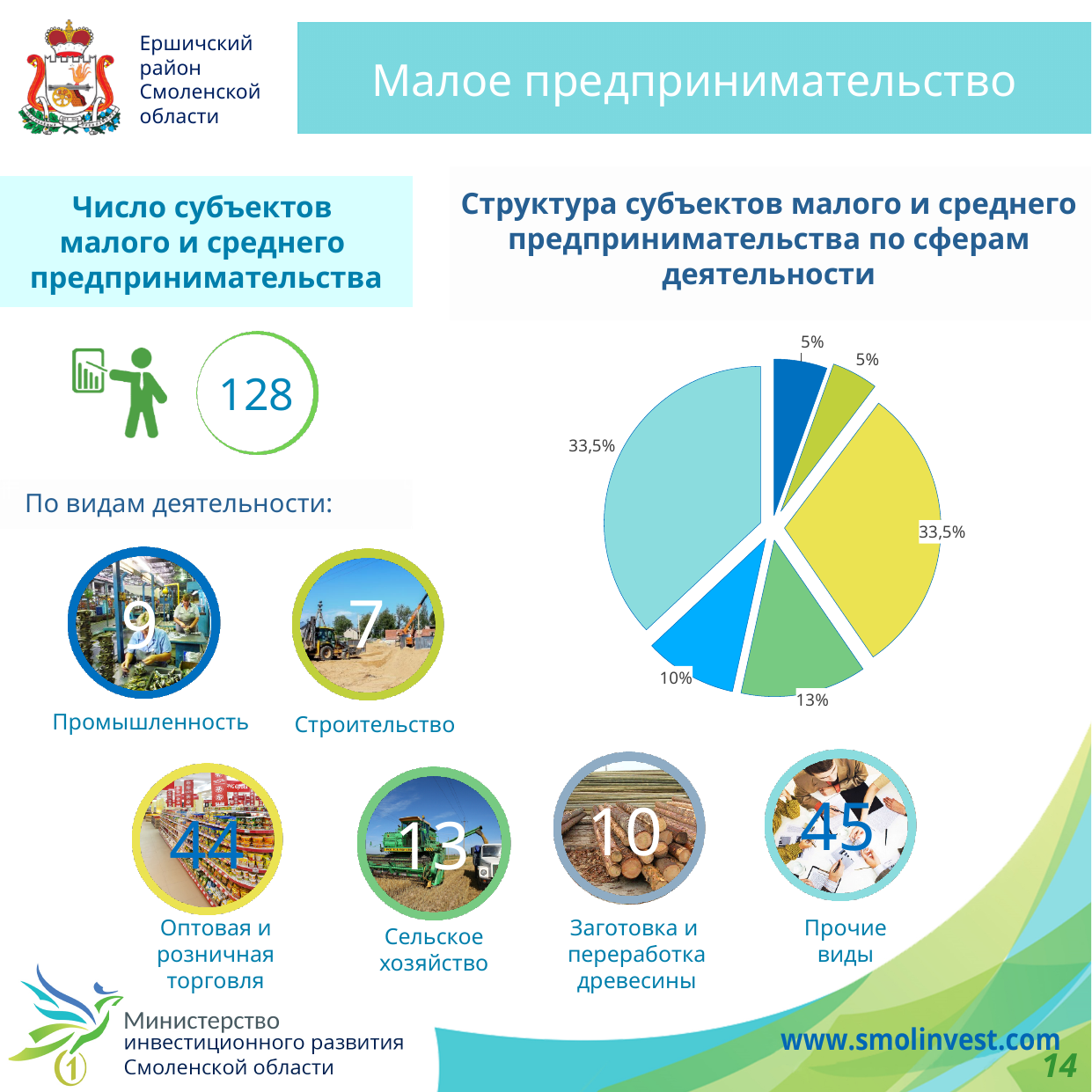
Does the pie chart have a legend? No How many slices of the pie chart are labelled 33,5%? 2 What is the largest share shown on the pie chart? 33,5% How many slices does the pie chart have? 6 Which is larger on the pie chart: the green slice labelled 13% or the cyan slice labelled 10%? 13% What is the combined share of the two slices labelled 33,5% on the pie chart? 67% What is the smallest share shown on the pie chart? 5% How many slices of the pie chart are labelled 5%? 2 What is the title of the pie chart? Структура субъектов малого и среднего предпринимательства по сферам деятельности What kind of chart is shown under the title "Структура субъектов малого и среднего предпринимательства по сферам деятельности"? pie chart What is the difference between the pie slice labelled 13% and the slice labelled 10%? 3%